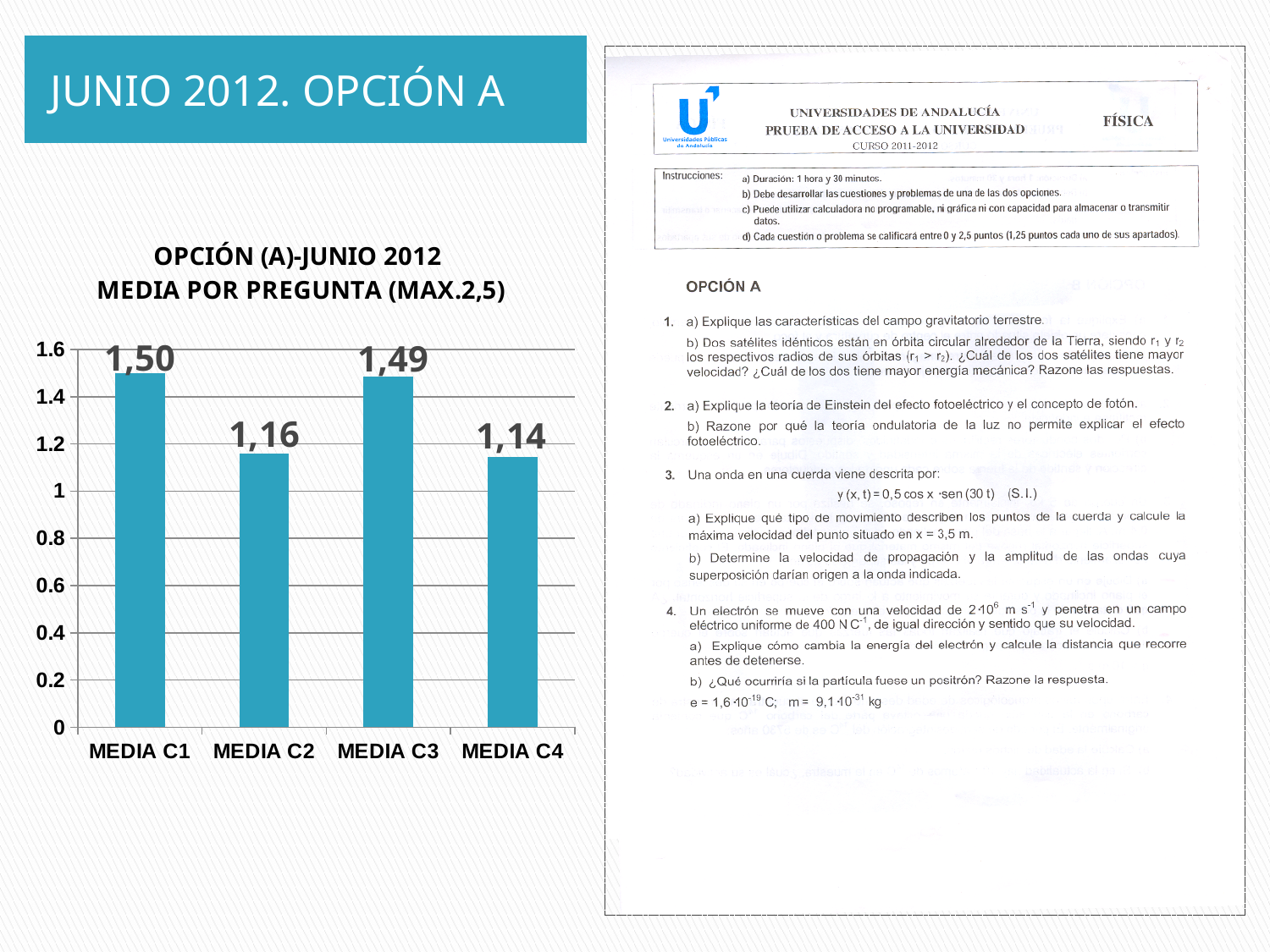
Which category has the highest value? MEDIA C1 Which is larger, the value for MEDIA C3 or the value for MEDIA C2? MEDIA C3 What is the value for MEDIA C2? 1,16 What is the title of the chart? OPCIÓN (A)-JUNIO 2012 MEDIA POR PREGUNTA (MAX.2,5) What is the value for MEDIA C3? 1,49 What is the value for MEDIA C4? 1,14 How many categories are shown in the chart? 4 What is the difference between the values for MEDIA C3 and MEDIA C4? 0,35 What kind of chart is shown on the slide? Bar chart Which category has the lowest value? MEDIA C4 What is the value for MEDIA C1? 1,50 What is the difference between the values for MEDIA C1 and MEDIA C2? 0,34